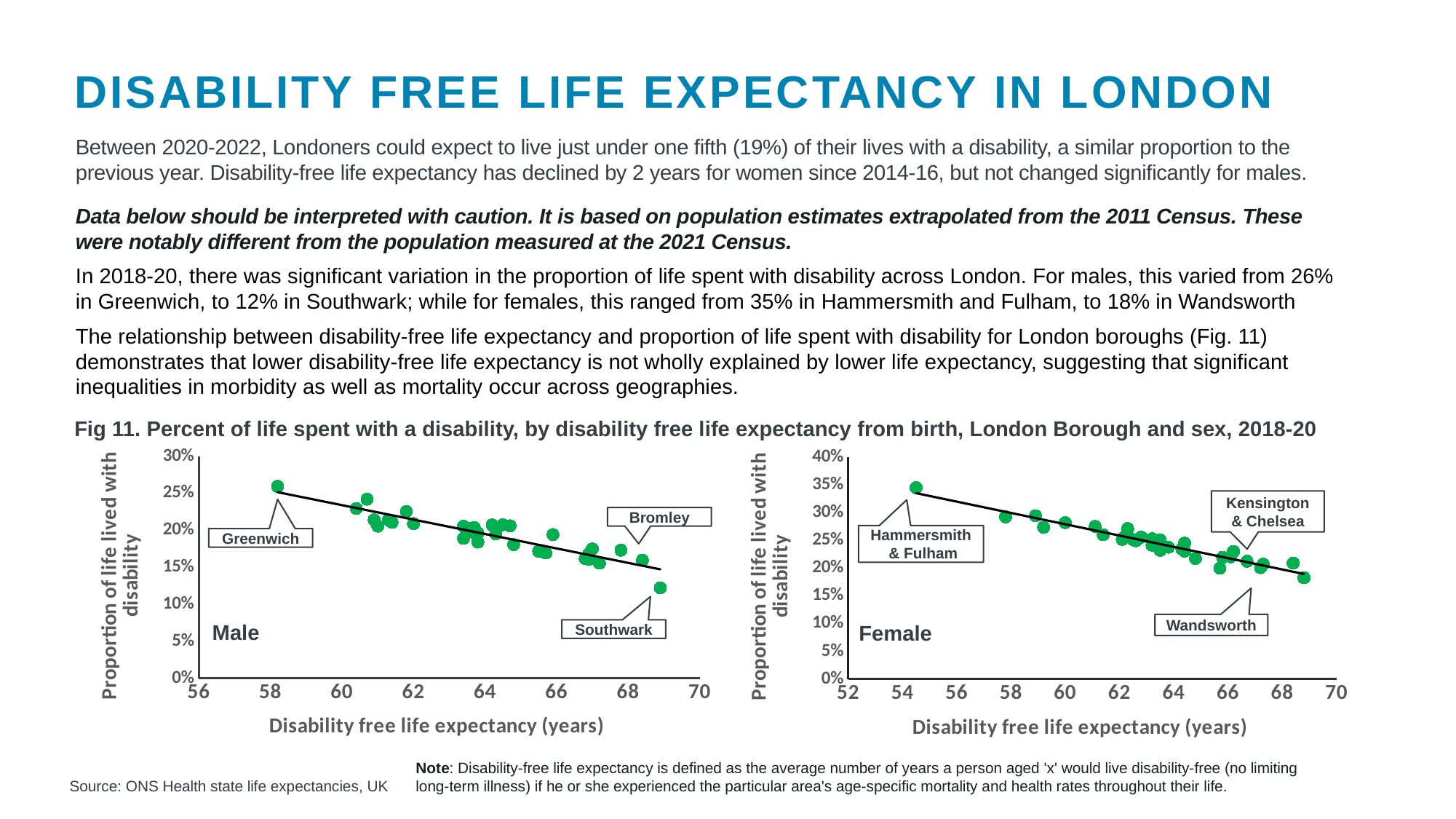
What is the highest value shown on the y-axis of the Female chart? 40% In the Female chart, is the proportion of life lived with disability for Hammersmith & Fulham greater or less than 30%? greater What is the x-axis title of the Male chart? Disability free life expectancy (years) In the Female chart, which has the higher proportion of life lived with disability, Hammersmith & Fulham or Kensington & Chelsea? Hammersmith & Fulham In the Female chart, is the proportion of life lived with disability for Wandsworth greater or less than 20%? less What kind of chart is used in Fig 11 for the Male and Female panels? Scatter chart In the Female chart, which labelled borough has the lowest proportion of life lived with disability? Wandsworth In the Male chart, does the proportion of life lived with disability rise or fall as disability free life expectancy increases? Fall In the Male chart, is the proportion of life lived with disability for Greenwich greater or less than 20%? greater In the Male chart, which has the higher proportion of life lived with disability, Greenwich or Southwark? Greenwich